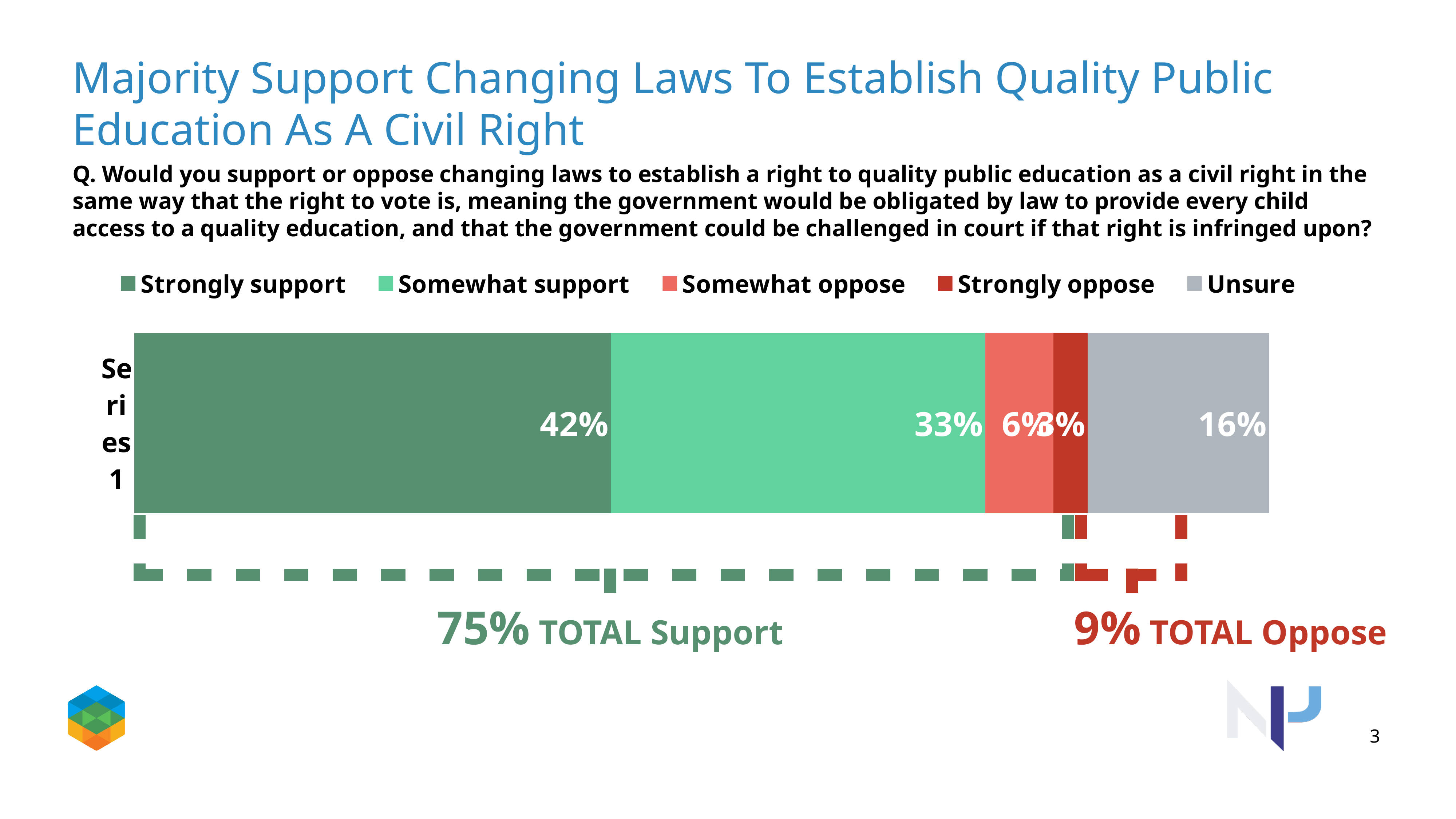
Which response category has the smallest share? Strongly oppose What is the value for Somewhat support? 33% What is the total oppose percentage shown below the bar? 9% How many series does the legend list? 5 Which is larger, Unsure or Somewhat support? Somewhat support Which response category has the largest share? Strongly support What is the value for Somewhat oppose? 6% What is the total support percentage shown below the bar? 75% What kind of chart is shown on the slide? bar chart What is the difference between Strongly support and Somewhat support? 9 percentage points What percentage of respondents strongly support changing the laws? 42% What is the value for Unsure? 16%